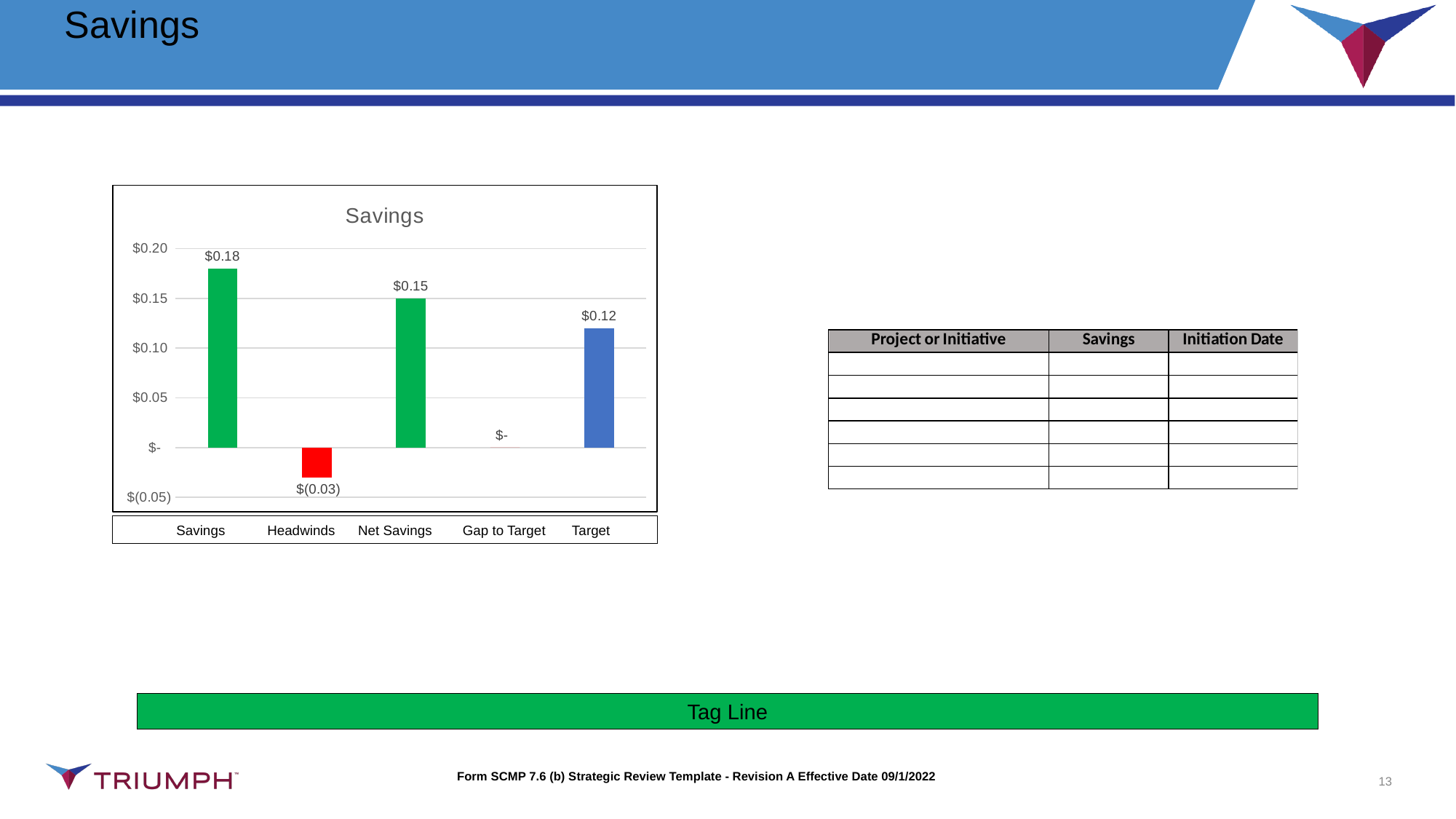
Which bar in the Savings chart has the highest value? Savings How many bars (categories) are plotted in the Savings chart? 5 What is the difference between the Savings bar and the Net Savings bar? $0.03 What colour is the Headwinds bar? Red What value is labelled for Gap to Target? $- What is the value of the Net Savings bar? $0.15 What type of chart is shown on the slide? Bar chart What is the value shown for Headwinds in the Savings chart? $(0.03) What is the value of the Savings bar in the Savings chart? $0.18 What is the value of the Target bar? $0.12 Which bar in the Savings chart has the lowest value? Headwinds Which is larger, Net Savings or Target? Net Savings